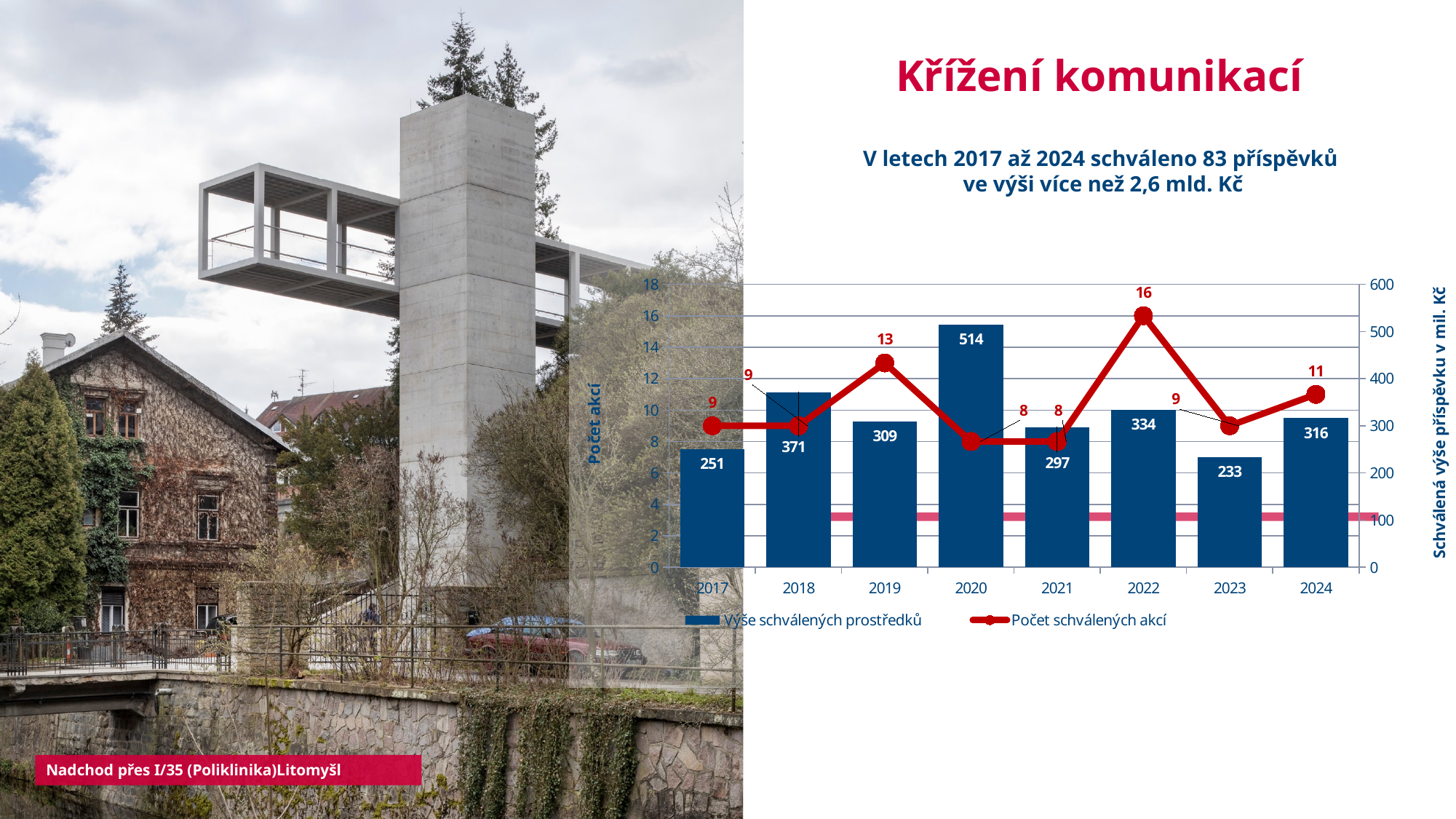
What is the value of Počet schválených akcí for 2022? 16 Which is larger, Výše schválených prostředků in 2018 or in 2024? 2018 Which year has the highest Počet schválených akcí? 2022 Which year has the highest Výše schválených prostředků? 2020 What is the value of Výše schválených prostředků for 2023? 233 Does Výše schválených prostředků rise or fall from 2022 to 2023? fall How many years are shown on the x axis of the chart? 8 How many series does the chart legend list? 2 What is the difference between Výše schválených prostředků in 2020 and 2023? 281 Which year has the lowest Výše schválených prostředků? 2023 What is the title of the slide containing the chart? Křížení komunikací What is the value of Výše schválených prostředků for 2020? 514